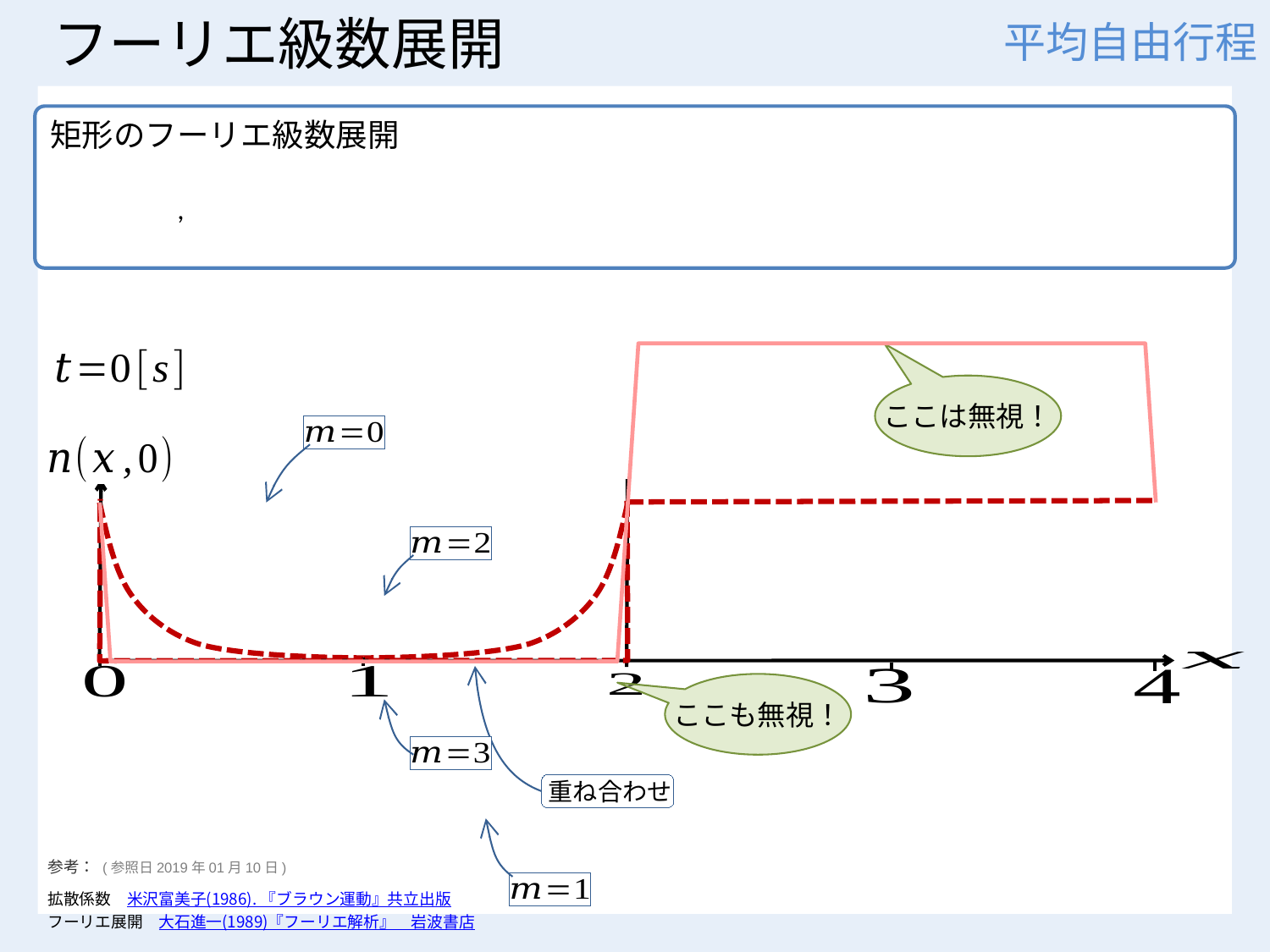
What time value is written above the chart? t=0[s] How many different values of m are labelled on the chart? 4 What kind of chart is shown on the slide? line chart What is the label on the vertical axis of the chart? n(x,0) What is the label on the horizontal axis of the chart? x How many tick labels are shown on the x axis of the chart? 5 What is the largest tick value shown on the x axis? 4 What is the smallest tick value shown on the x axis? 0